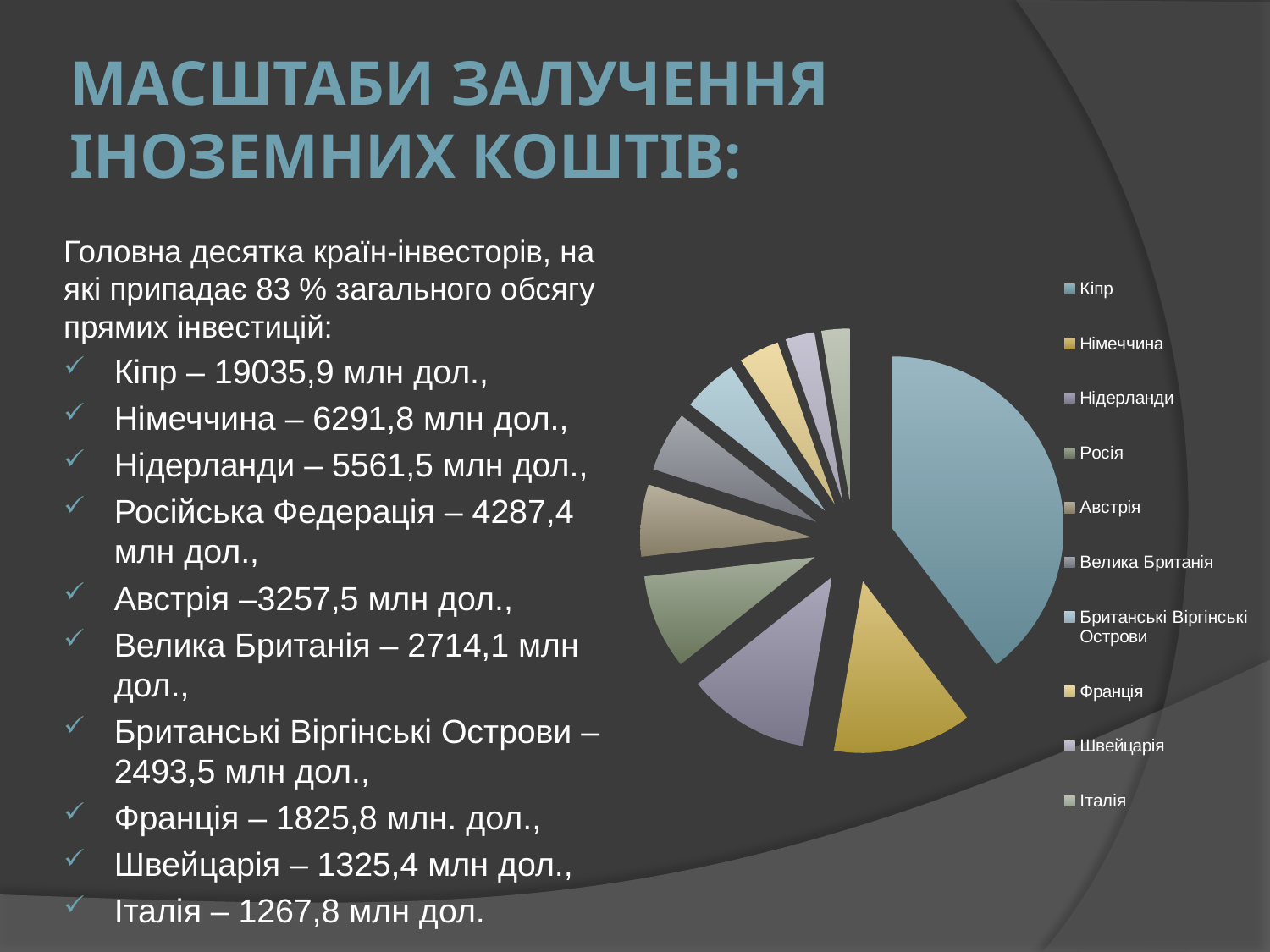
Which slice is larger in the pie chart, Кіпр or Німеччина? Кіпр What is the difference between the values for Кіпр and Німеччина shown on the slide? 12744,1 млн дол. How many slices does the pie chart have? 10 Which slice is larger in the pie chart, Росія or Австрія? Росія How many entries does the legend of the pie chart list? 10 According to the slide, what is the value for Франція? 1825,8 млн. дол. Which slice is larger in the pie chart, Німеччина or Велика Британія? Німеччина Which legend entry is listed first in the pie chart's legend? Кіпр Which country has the largest slice in the pie chart? Кіпр According to the slide, what is the value for Італія? 1267,8 млн дол. According to the slide, what is the value for Кіпр? 19035,9 млн дол. What kind of chart is shown on the slide? pie chart